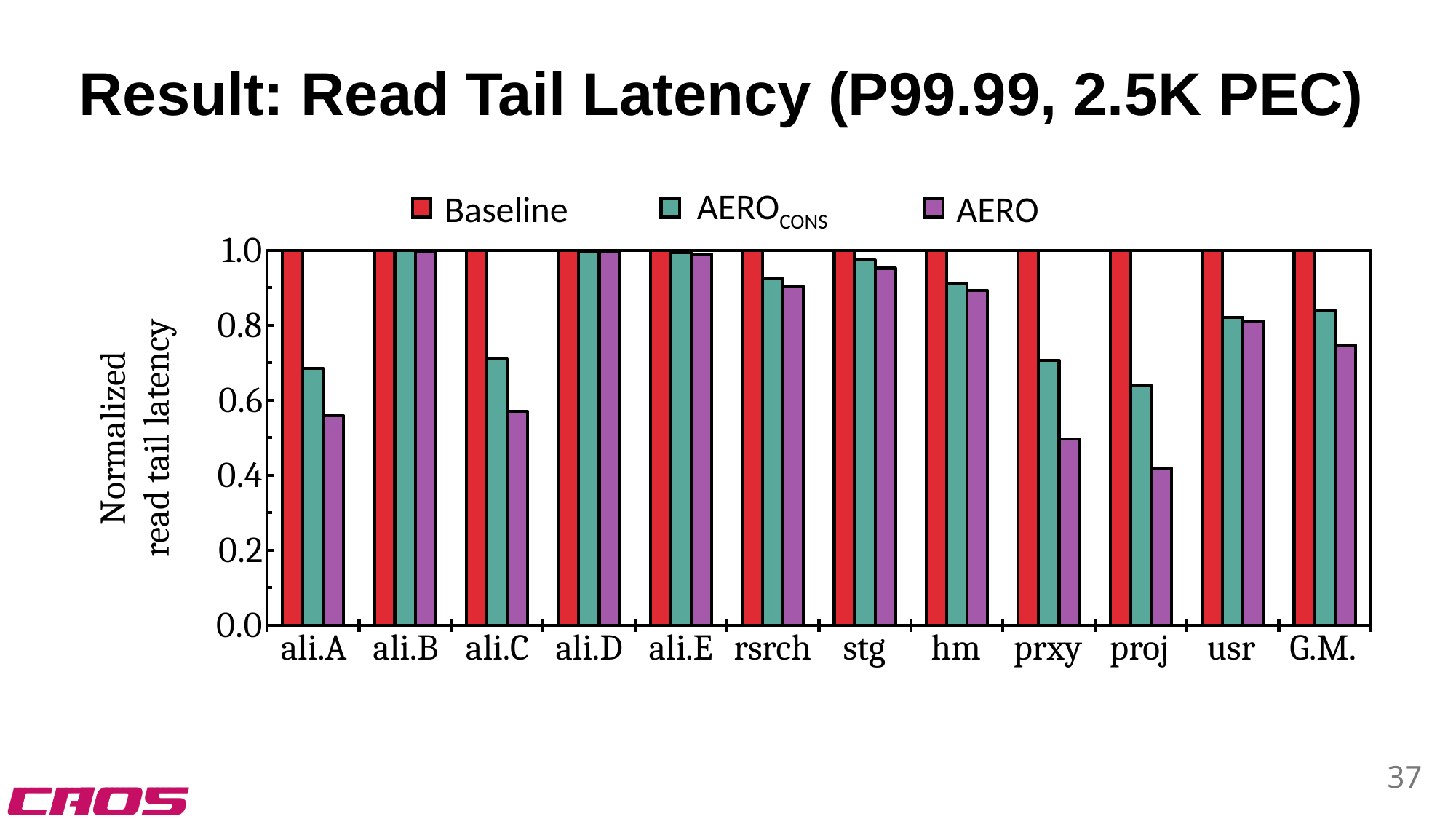
Is the AERO value for proj greater or less than 0.6? less Which category has the lowest AERO value? proj For prxy, which is larger, the AERO_CONS value or the AERO value? AERO_CONS What kind of chart is shown on the slide? bar chart What is the label of the y axis? Normalized read tail latency Is the AERO value for ali.A greater or less than 0.8? less How many categories are shown on the x axis? 12 Which is larger, the AERO value for ali.A or the AERO value for ali.B? ali.B Is the AERO value for usr greater or less than 0.6? greater What is the Baseline value for ali.A? 1.0 How many series does the legend list? 3